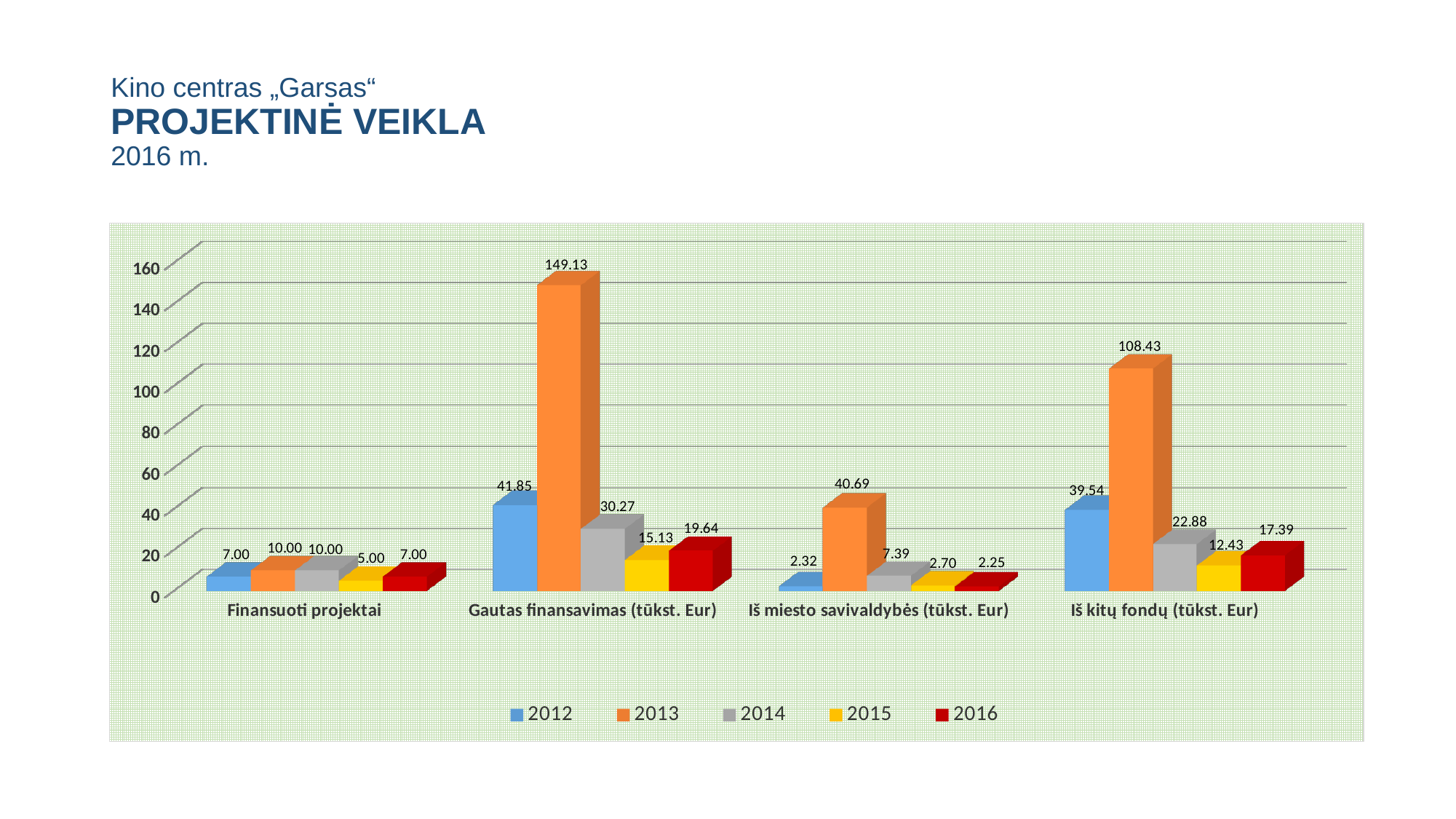
Which is larger in the "Iš kitų fondų (tūkst. Eur)" category: the 2014 value or the 2015 value? 2014 How many categories are shown on the x axis? 4 What is the value for 2016 in the "Iš kitų fondų (tūkst. Eur)" category? 17.39 What is the value for 2013 in the "Gautas finansavimas (tūkst. Eur)" category? 149.13 What is the value for 2015 in the "Finansuoti projektai" category? 5.00 What kind of chart is shown on the slide? Bar chart Which year has the lowest value in the "Iš miesto savivaldybės (tūkst. Eur)" category? 2016 How many series does the legend list? 5 Which colour represents the 2013 series in the legend? Orange What is the difference between the 2013 and 2012 values in the "Gautas finansavimas (tūkst. Eur)" category? 107.28 Which year has the highest value in the "Iš kitų fondų (tūkst. Eur)" category? 2013 What is the value for 2012 in the "Iš miesto savivaldybės (tūkst. Eur)" category? 2.32